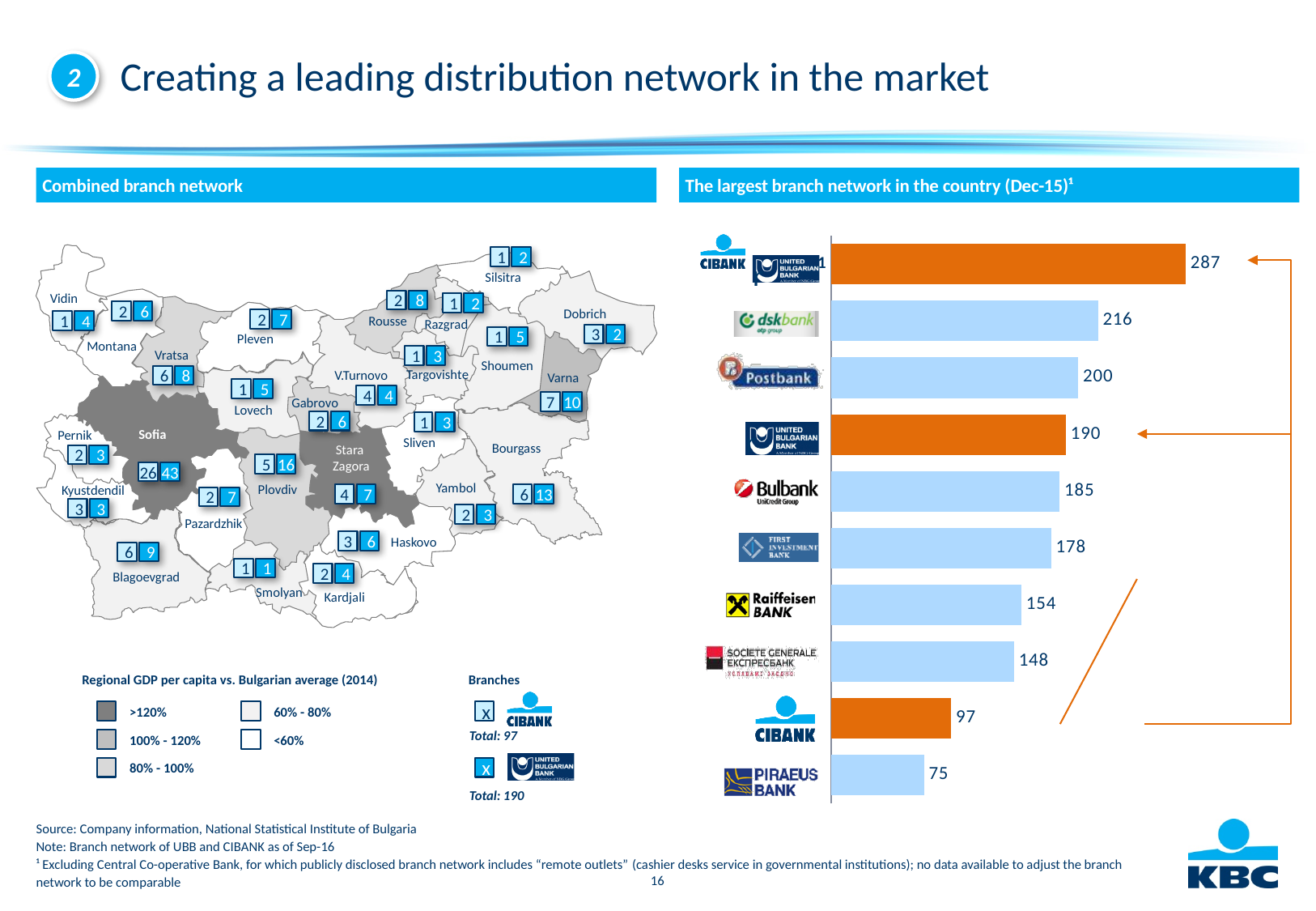
In the bar chart 'The largest branch network in the country (Dec-15)', what is the difference between the values for DSK Bank and United Bulgarian Bank? 26 In the bar chart 'The largest branch network in the country (Dec-15)', what is the difference between the values for Bulbank and First Investment Bank? 7 In the bar chart 'The largest branch network in the country (Dec-15)', what is the value shown for Postbank? 200 What kind of chart is 'The largest branch network in the country (Dec-15)'? Bar chart In the bar chart 'The largest branch network in the country (Dec-15)', which is larger: the value for Raiffeisen Bank or the value for Societe Generale Expressbank? Raiffeisen Bank How many bars are shown in the bar chart 'The largest branch network in the country (Dec-15)'? 10 In the bar chart 'The largest branch network in the country (Dec-15)', what is the value shown for Raiffeisen Bank? 154 In the bar chart 'The largest branch network in the country (Dec-15)', which bar has the highest value? CIBANK and United Bulgarian Bank combined (287) In the bar chart 'The largest branch network in the country (Dec-15)', what is the value shown for DSK Bank? 216 In the bar chart 'The largest branch network in the country (Dec-15)', how many bars are coloured orange? 3 In the bar chart 'The largest branch network in the country (Dec-15)', which bank has the lowest value? Piraeus Bank In the bar chart 'The largest branch network in the country (Dec-15)', what is the value shown for Piraeus Bank? 75